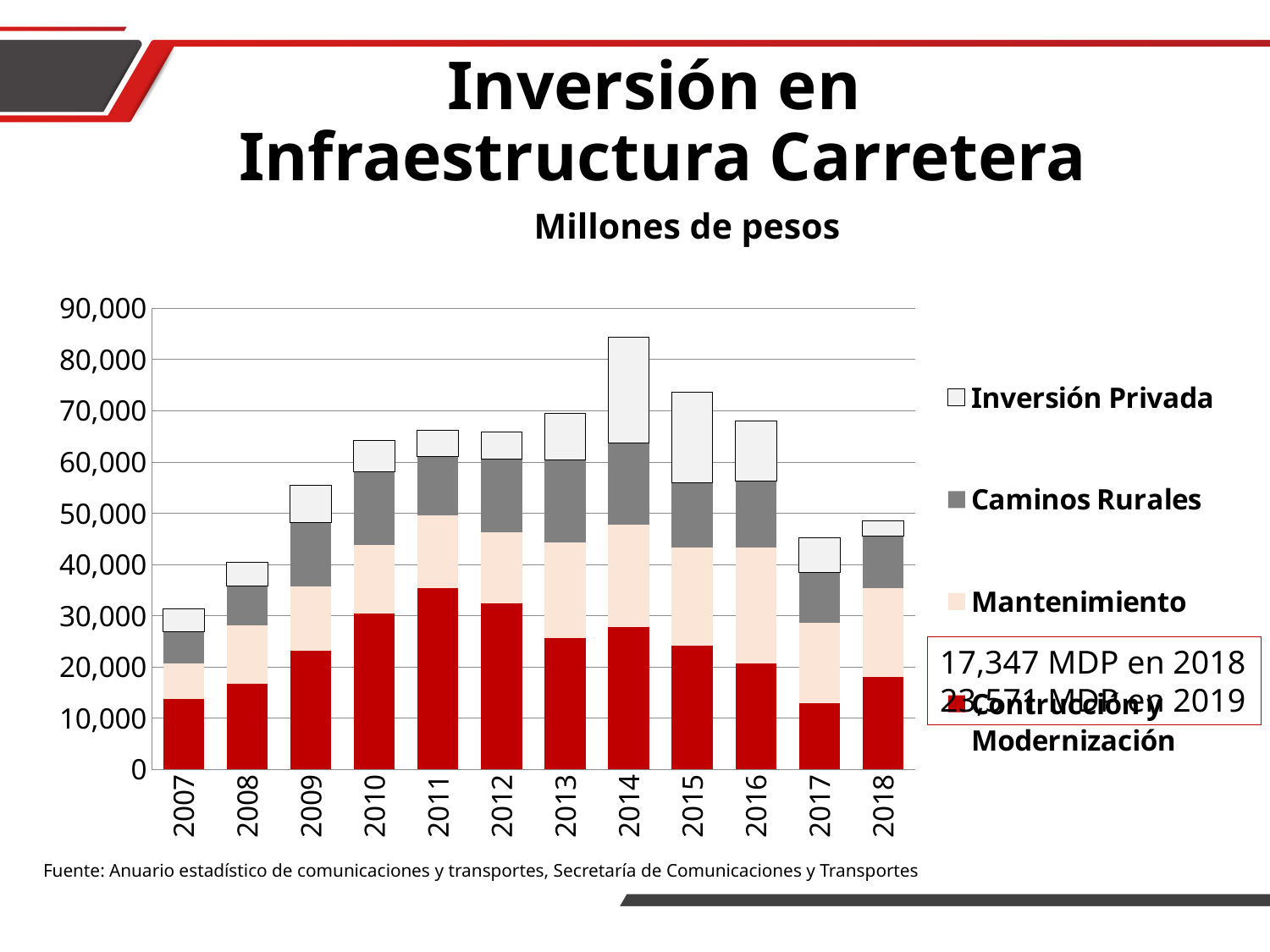
Which year has the highest total investment bar? 2014 Which year has a larger total bar, 2014 or 2015? 2014 Is the Construcción y Modernización value for 2017 greater or less than 20,000? less Which year has the lowest total investment bar? 2007 Do the total bars rise or fall from 2014 to 2017? fall Which series is shown in red in the chart? Construcción y Modernización How many years are shown on the x axis of the chart? 12 How many series does the chart legend list? 4 What kind of chart is shown on the slide? Stacked bar chart Is the Construcción y Modernización value for 2011 greater or less than 30,000? greater Is the total bar for 2014 greater or less than 80,000? greater